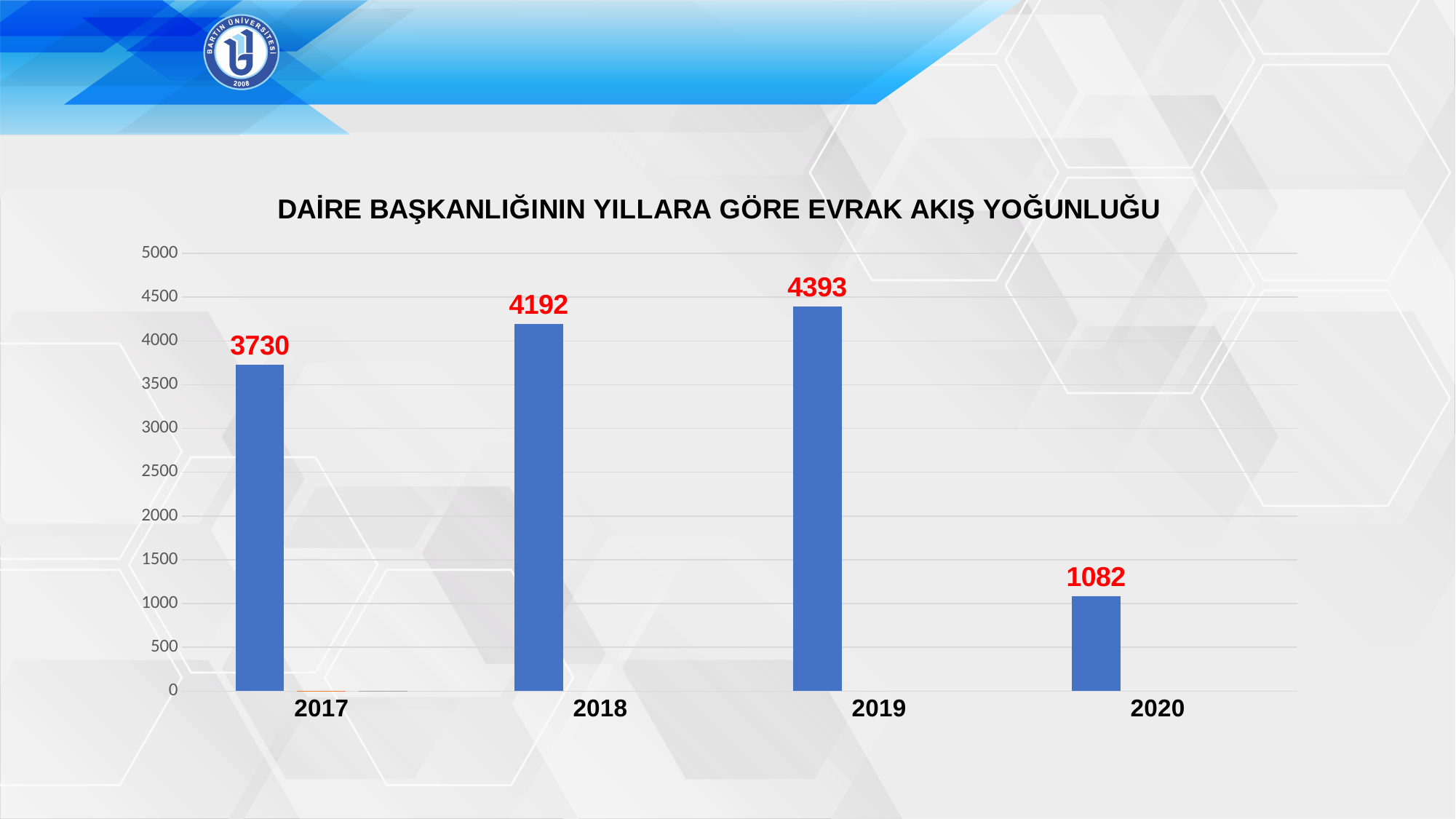
Is the value for 2020 greater or less than 1500? less What is the value for 2020? 1082 Which year has the lowest value? 2020 What is the title of the chart? DAİRE BAŞKANLIĞININ YILLARA GÖRE EVRAK AKIŞ YOĞUNLUĞU What is the difference between the values for 2017 and 2020? 2648 What is the difference between the values for 2019 and 2018? 201 Which year has the highest value? 2019 What kind of chart is this? bar chart How many years are shown on the chart? 4 What is the value for 2017? 3730 What is the value for 2019? 4393 Which is larger, the value for 2017 or the value for 2018? 2018